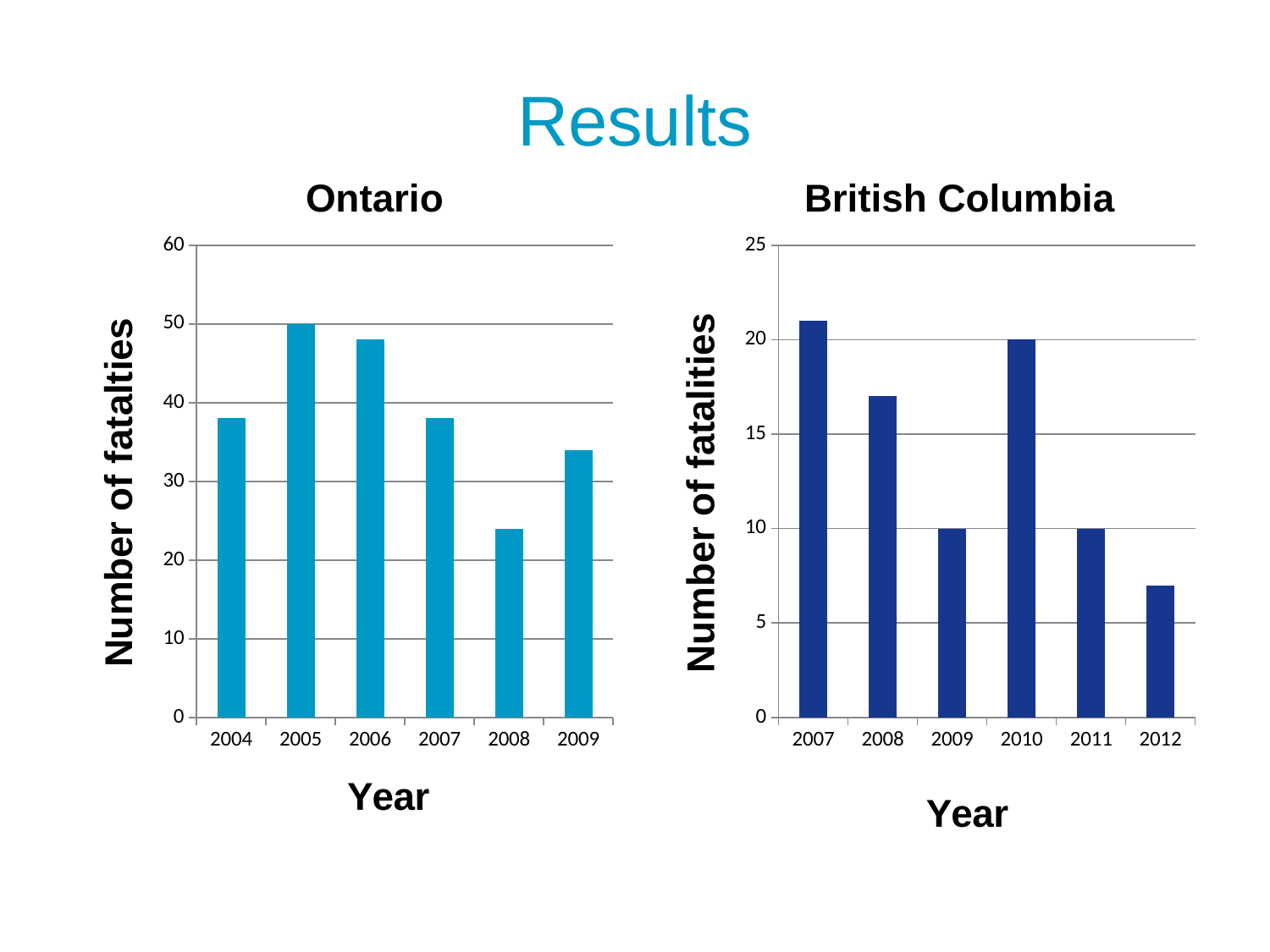
On the British Columbia chart, is the value for 2012 greater or less than 10? less What type of chart is the Ontario chart? Bar chart On the British Columbia chart, what is the number of fatalities in 2009? 10 On the Ontario chart, which year has more fatalities, 2006 or 2008? 2006 How many years are shown on the British Columbia chart? 6 On the British Columbia chart, what is the number of fatalities in 2010? 20 On the Ontario chart, which year has the highest number of fatalities? 2005 On the Ontario chart, is the value for 2008 greater or less than 30? less On the Ontario chart, which year has the lowest number of fatalities? 2008 On the British Columbia chart, which year has the lowest number of fatalities? 2012 On the Ontario chart, what is the number of fatalities in 2005? 50 On the British Columbia chart, what is the difference in fatalities between 2010 and 2011? 10